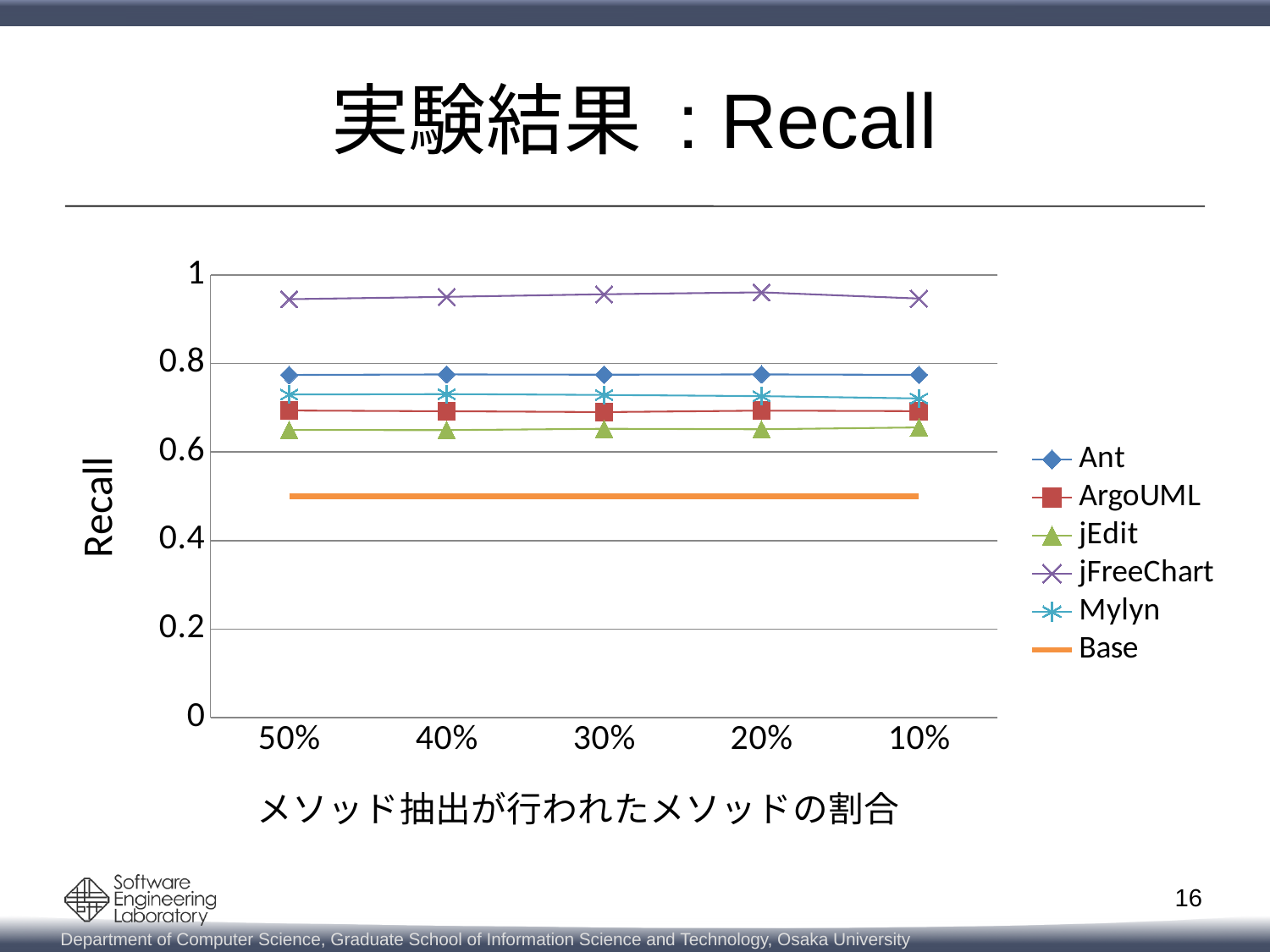
Is the Recall value for Base greater or less than 0.6? less Which series has the lowest Recall values across the chart? Base At 10%, which series has the higher Recall, jEdit or Mylyn? Mylyn How many series does the legend list? 6 Is the Recall value for Ant at 30% greater or less than 0.6? greater Is the Recall value for jFreeChart at 50% greater or less than 0.8? greater What kind of chart is shown on the slide? line chart Does the Ant series rise, fall, or stay roughly flat from 50% to 10%? roughly flat How many categories are shown on the x axis? 5 What is the label on the y axis of the chart? Recall Which series has the highest Recall values across the chart? jFreeChart At 20%, which series has the higher Recall, Ant or ArgoUML? Ant